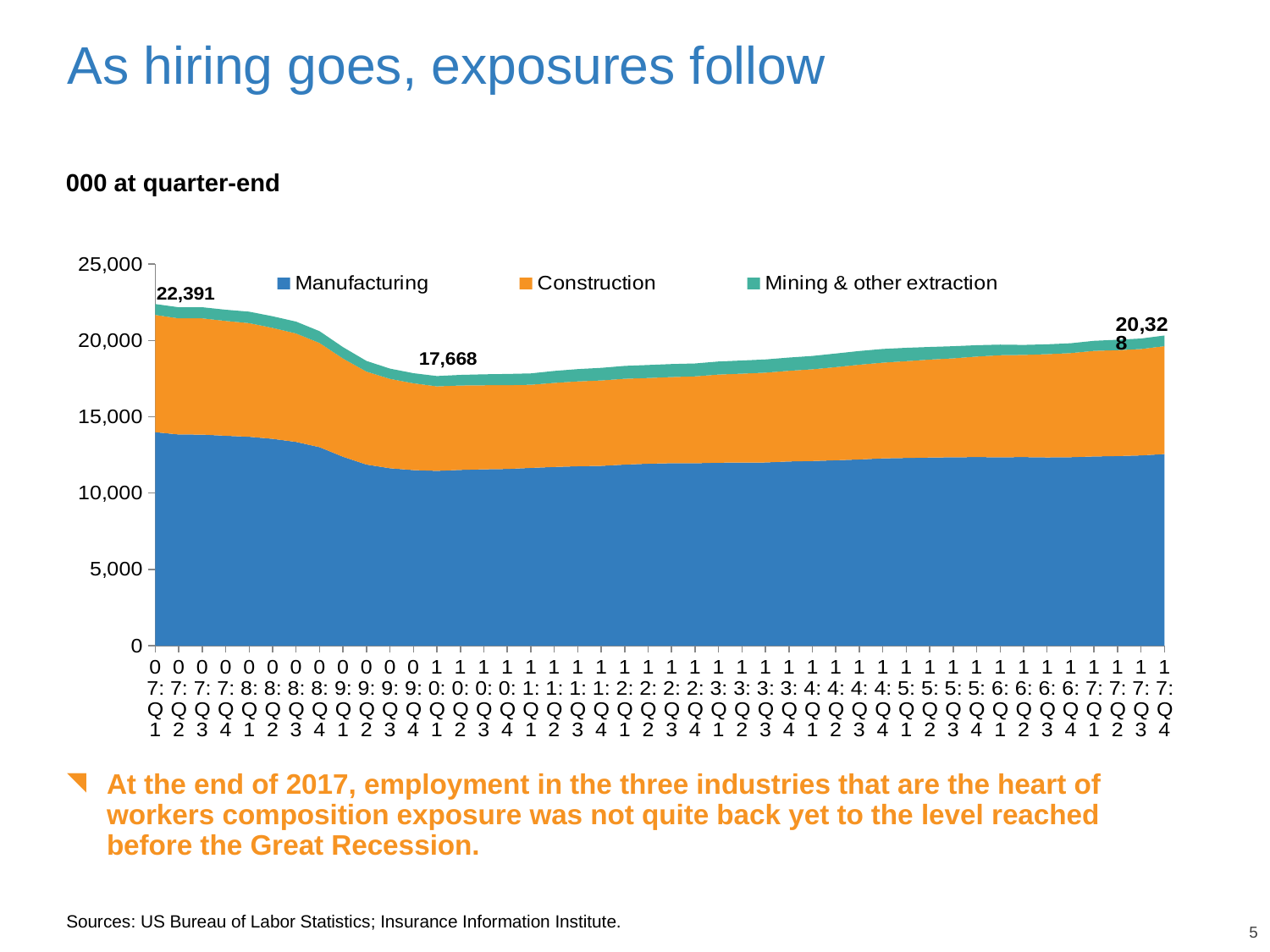
Which is larger, the labelled total at 07:Q1 or at 17:Q4? 07:Q1 What kind of chart is shown on the slide? Stacked area chart How many quarters are plotted along the x axis? 44 Does the total employment rise or fall from 07:Q1 to the trough around 2010? Fall What is the labelled total employment at 17:Q4? 20,328 What is the lowest labelled total on the chart? 17,668 Which colour represents Construction in the chart? Orange What is the labelled total employment at 07:Q1? 22,391 How many series does the chart's legend list? 3 What is the difference between the labelled totals at 07:Q1 and 17:Q4? 2,063 Is the Manufacturing value at 07:Q1 greater or less than 15,000? less What is the difference between the labelled total at 07:Q1 and the lowest labelled total of 17,668? 4,723